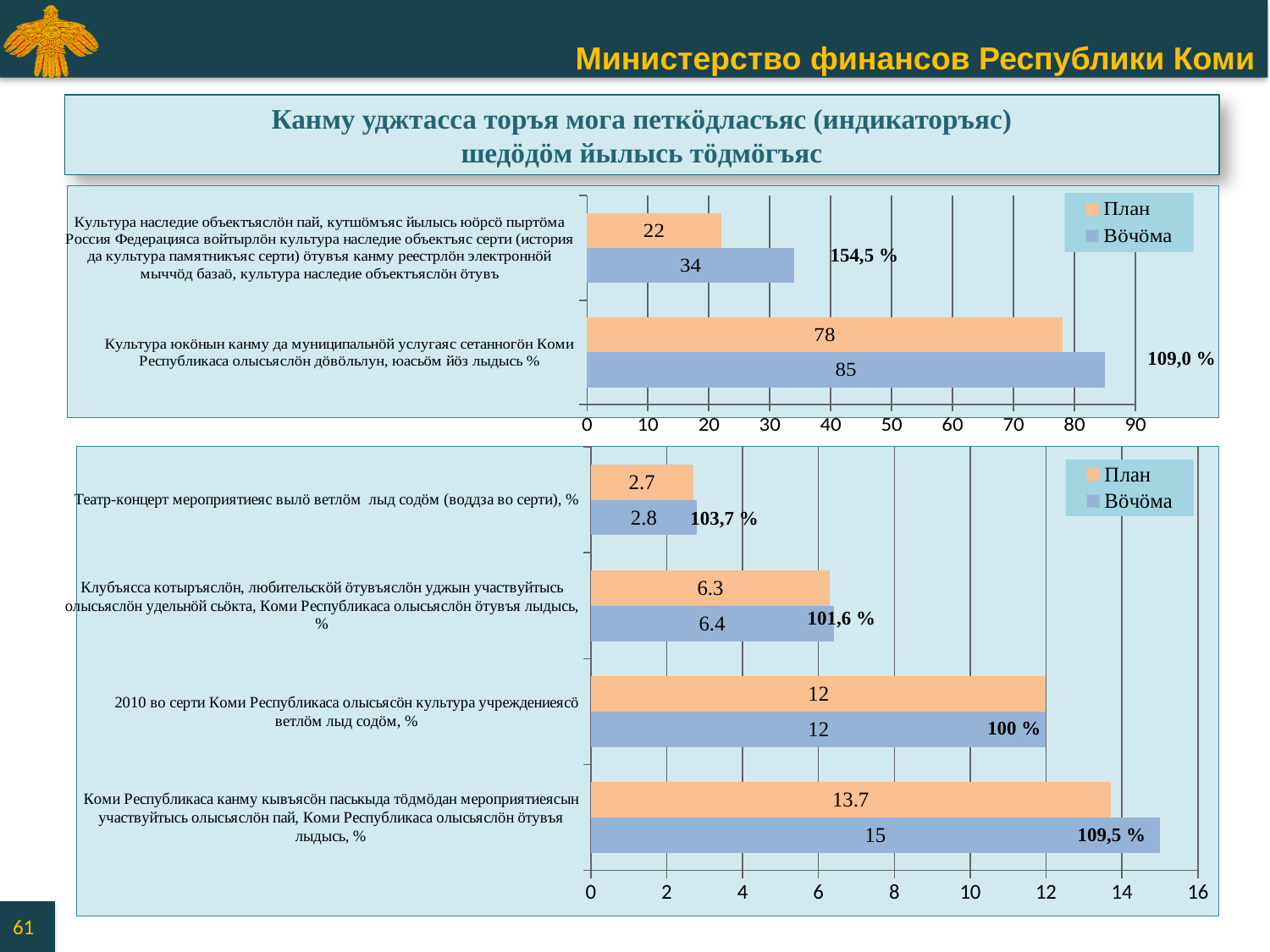
In the top chart, what percentage label is shown next to the bars for 'Культура наследие объектъяслöн пай...'? 154,5 % In the top chart, how many series does the legend list? 2 In the bottom chart, which category has the highest Вöчöма value? Коми Республикаса канму кывъясöн паськыда тöдмöдан мероприятиеясын участвуйтысь олысьяслöн пай In the top chart, what is the План value for the category 'Культура юкöнын канму да муниципальнöй услугаяс...'? 78 In the bottom chart, what is the difference between the Вöчöма and План values for 'Коми Республикаса канму кывъясöн паськыда тöдмöдан мероприятиеясын...'? 1.3 In the bottom chart, how many categories are plotted? 4 In the top chart, what is the difference between the Вöчöма and План values for the category 'Культура юкöнын канму да муниципальнöй услугаяс...'? 7 In the bottom chart, what is the План value for the category 'Театр-концерт мероприятиеяс вылö ветлöм лыд содöм'? 2.7 In the bottom chart, which category has the lowest План value? Театр-концерт мероприятиеяс вылö ветлöм лыд содöм (воддза во серти), % What type of chart is the bottom chart? Bar chart In the bottom chart, what is the Вöчöма value for the category 'Коми Республикаса канму кывъясöн паськыда тöдмöдан мероприятиеясын...'? 15 In the top chart, what is the Вöчöма value for the category 'Культура наследие объектъяслöн пай...'? 34